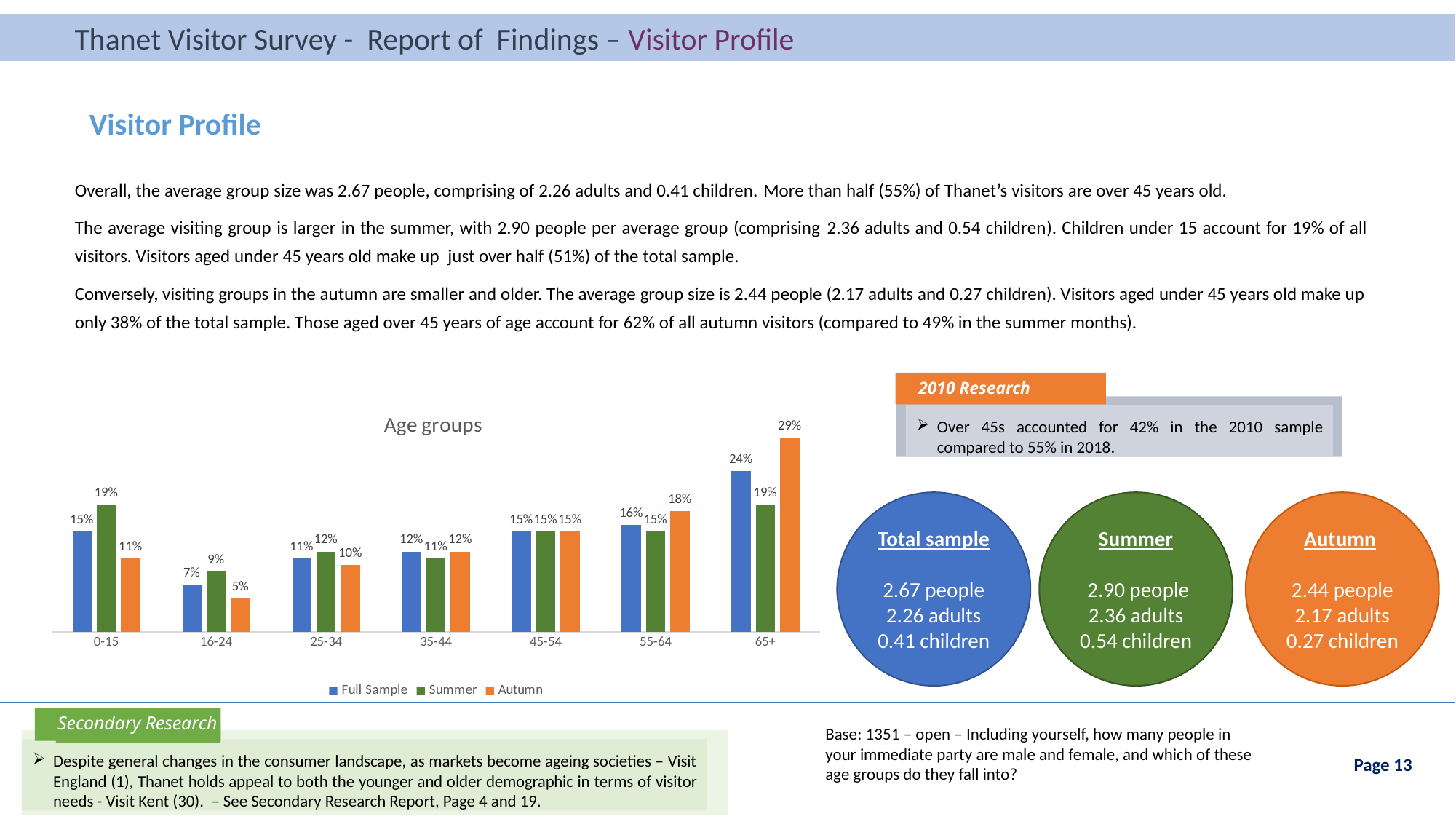
What is the Summer value for the 0-15 age group? 19% What is the Full Sample value for the 65+ age group? 24% Which age group has the highest Autumn value? 65+ What is the title of the chart? Age groups Which age group has the lowest Full Sample value? 16-24 What is the difference between the Autumn and Summer values for the 65+ age group? 10% What is the difference between the Full Sample values for the 65+ and 16-24 age groups? 17% What kind of chart is shown on the slide? Bar chart Is the Summer value or the Autumn value larger for the 0-15 age group? Summer How many series does the chart legend list? 3 What is the Autumn value for the 16-24 age group? 5% How many age groups are shown on the x axis of the chart? 7